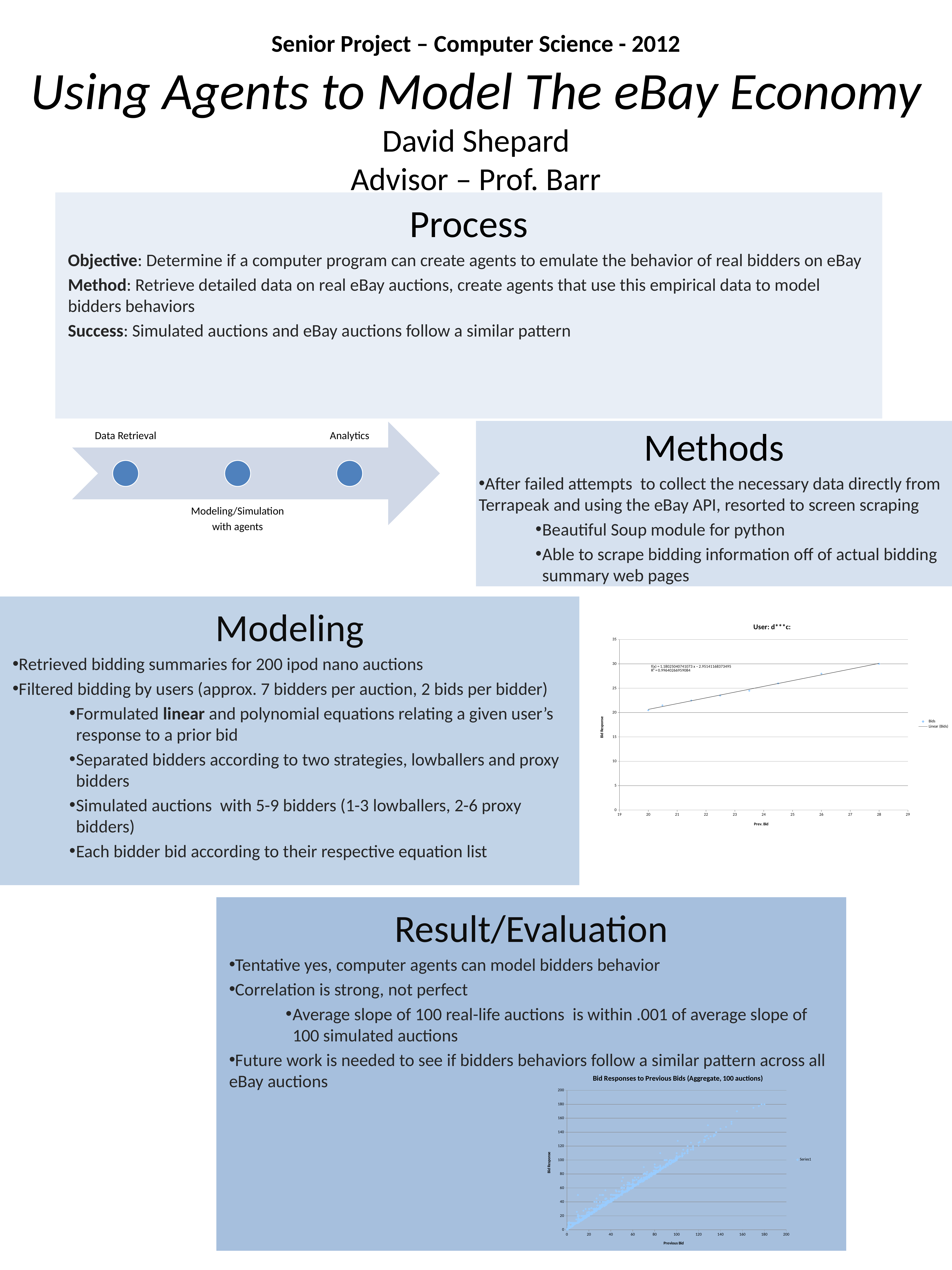
In the chart titled "User: d***c:", do the bid response values rise or fall as the previous bid increases? rise In the chart titled "User: d***c:", is the bid response for a previous bid of 20 greater or less than 25? less In the chart titled "User: d***c:", what are the two legend entries? Bids and Linear (Bids) In the chart titled "User: d***c:", is the bid response for a previous bid of 28 greater or less than 25? greater In the chart titled "Bid Responses to Previous Bids (Aggregate, 100 auctions)", do bid responses rise or fall as the previous bid increases? rise In the chart titled "User: d***c:", is the bid response for a previous bid of 26 greater or less than 30? less In the chart titled "User: d***c:", how many entries does the legend list? 2 In the chart titled "Bid Responses to Previous Bids (Aggregate, 100 auctions)", how many series does the legend list? 1 What is the title of the chart at the bottom of the slide? Bid Responses to Previous Bids (Aggregate, 100 auctions) What kind of chart is the chart titled "Bid Responses to Previous Bids (Aggregate, 100 auctions)"? scatter chart What kind of chart is the chart titled "User: d***c:"? scatter chart